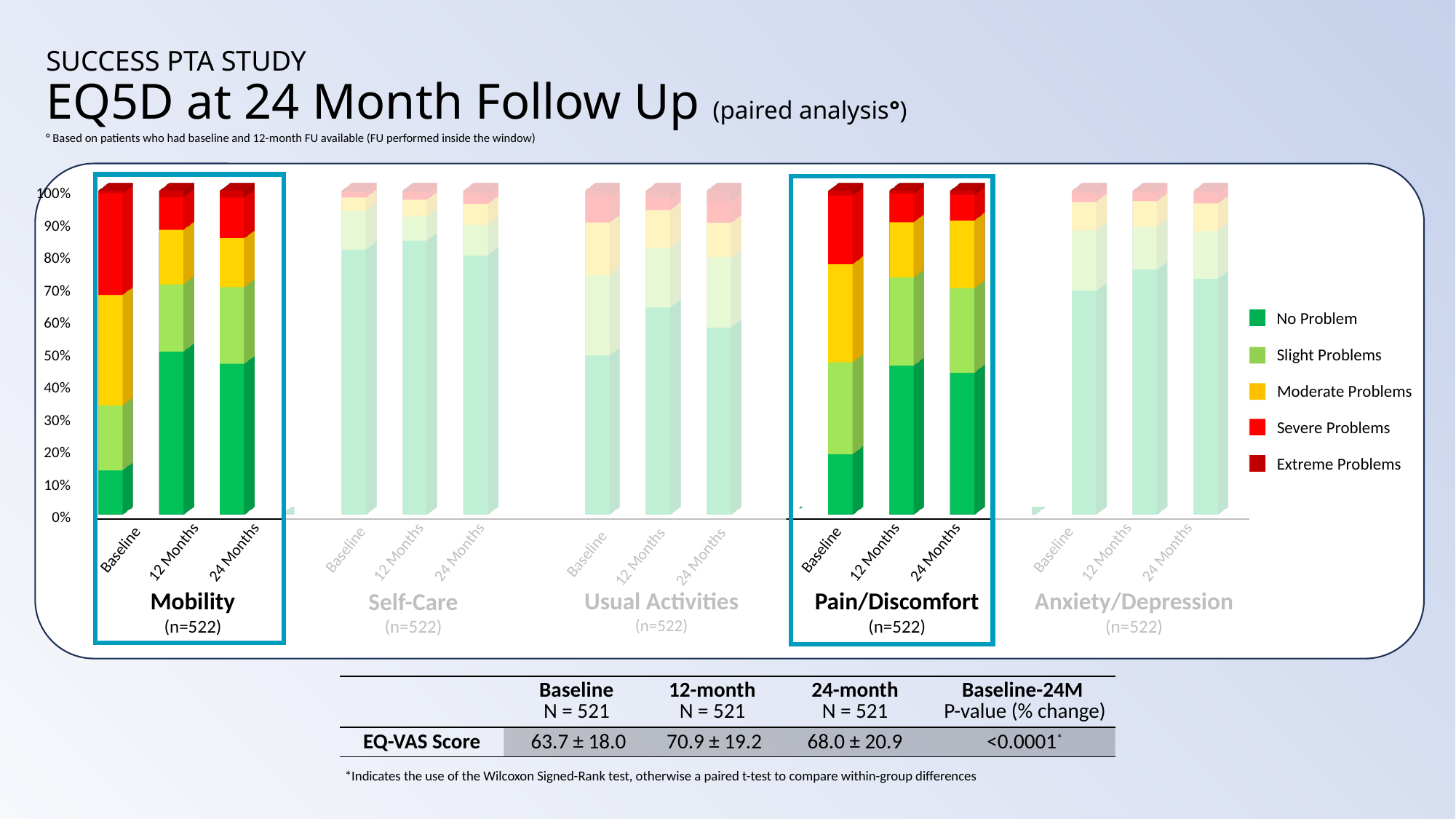
For Mobility, is the 'No Problem' share larger at Baseline or at 12 Months? 12 Months Which two dimensions are highlighted with blue boxes? Mobility and Pain/Discomfort How many EQ5D dimensions (category groups) are shown along the x axis? 5 What kind of chart is shown on the slide? Stacked bar chart Which colour represents 'No Problem' in the legend? Green For Pain/Discomfort, does the 'No Problem' share rise or fall from Baseline to 12 Months? rise Is the 'No Problem' share for Pain/Discomfort at 24 Months greater or less than 40%? greater How many time points are plotted for each dimension? 3 Is the 'No Problem' share for Mobility at Baseline greater or less than 20%? less Is the 'No Problem' share for Mobility at 12 Months greater or less than 40%? greater How many series does the legend list? 5 For Mobility, is the 'Severe Problems' share larger at Baseline or at 24 Months? Baseline